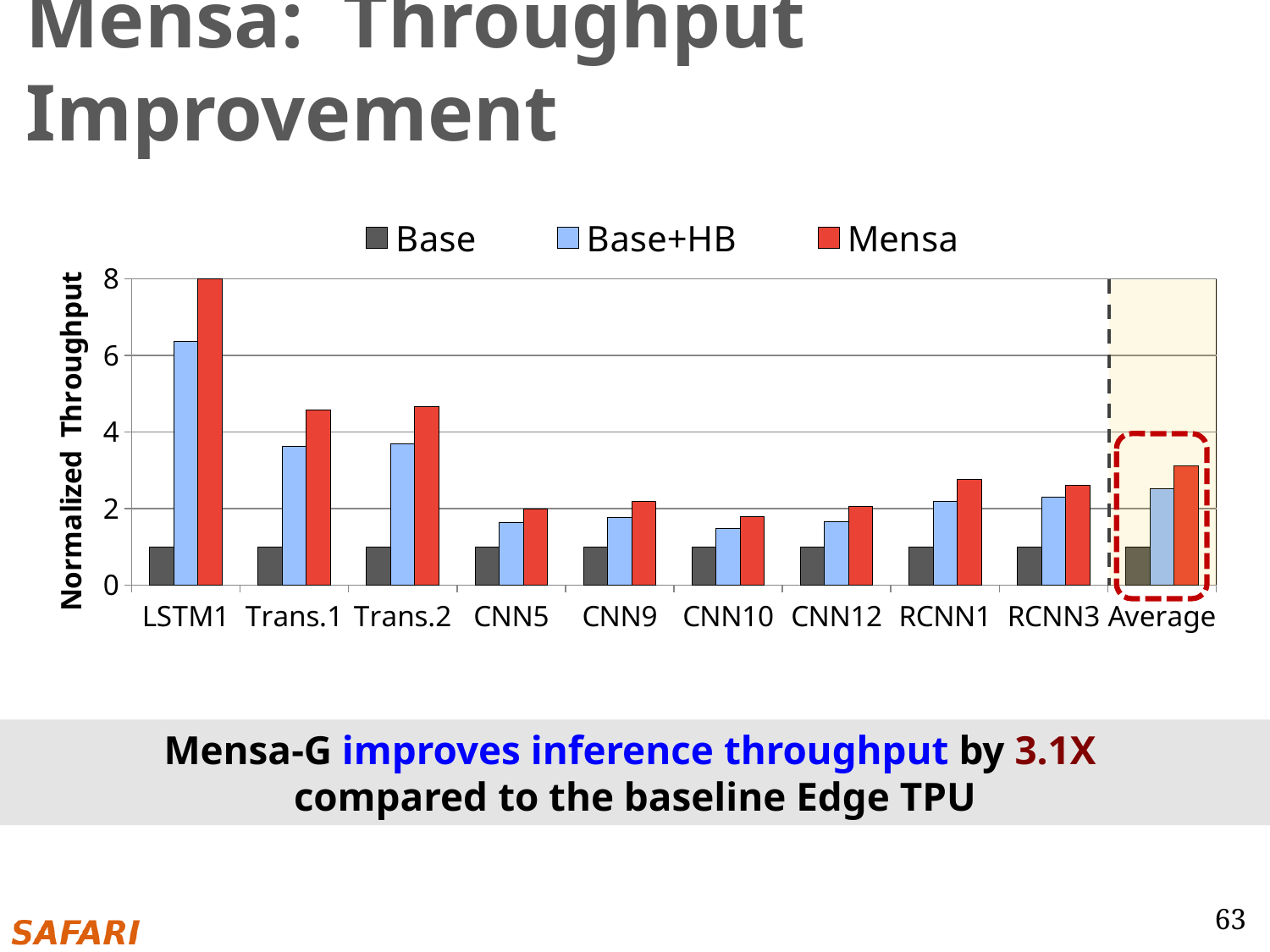
Is the Base+HB value for Trans.2 greater or less than 4? less What is the label of the y axis? Normalized Throughput Is the Mensa value for Trans.1 greater or less than 4? greater Which is larger: the Base+HB value for LSTM1 or the Mensa value for Trans.1? Base+HB value for LSTM1 What kind of chart is shown on the slide? bar chart How many categories are shown along the x axis? 10 Is the Mensa value for LSTM1 greater or less than 6? greater How many series does the legend list? 3 For which category is the Mensa bar the highest? LSTM1 Which is larger: the Mensa value for RCNN1 or the Mensa value for CNN12? Mensa value for RCNN1